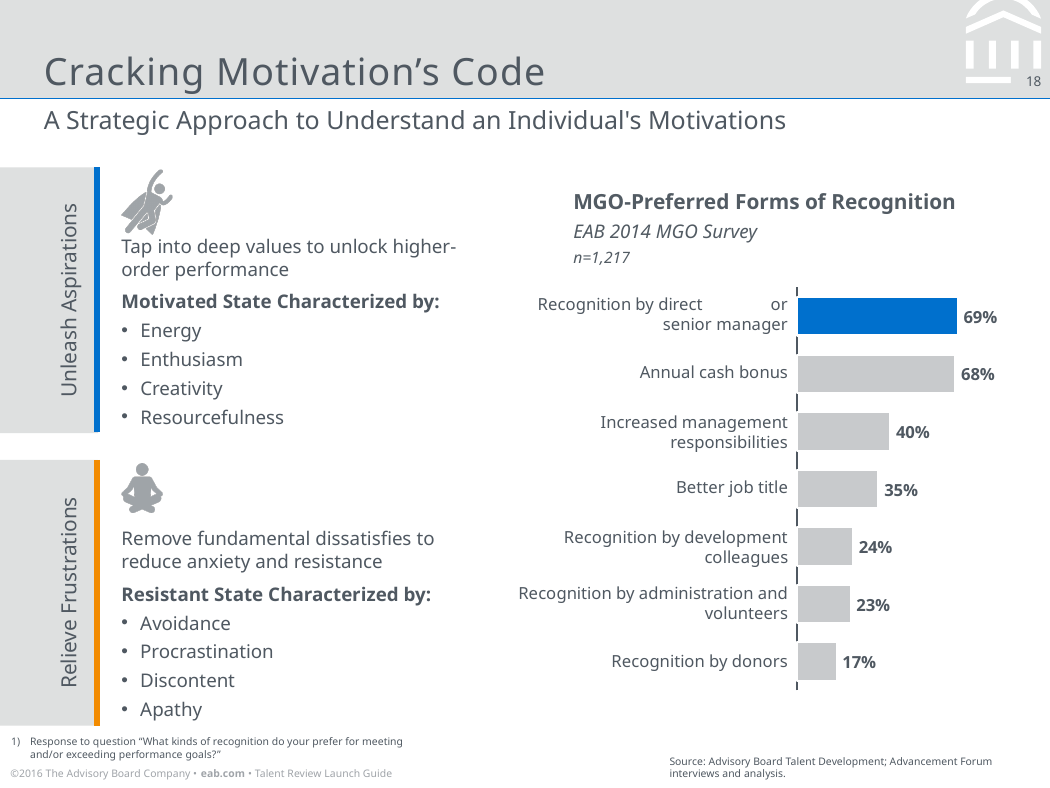
Which form of recognition has the highest percentage? Recognition by direct or senior manager How many forms of recognition are shown in the chart? 7 Which bar in the chart is highlighted in blue? Recognition by direct or senior manager What type of chart is used to show MGO-preferred forms of recognition? Bar chart What percentage is shown for Better job title? 35% What is the difference between Increased management responsibilities and Better job title? 5% What is the value for Annual cash bonus? 68% What is the value for Recognition by donors? 17% What percentage of MGOs preferred recognition by direct or senior manager? 69% What is the sample size (n) noted for the survey chart? n=1,217 Which form of recognition has the lowest percentage? Recognition by donors Which is larger: Recognition by development colleagues or Recognition by administration and volunteers? Recognition by development colleagues